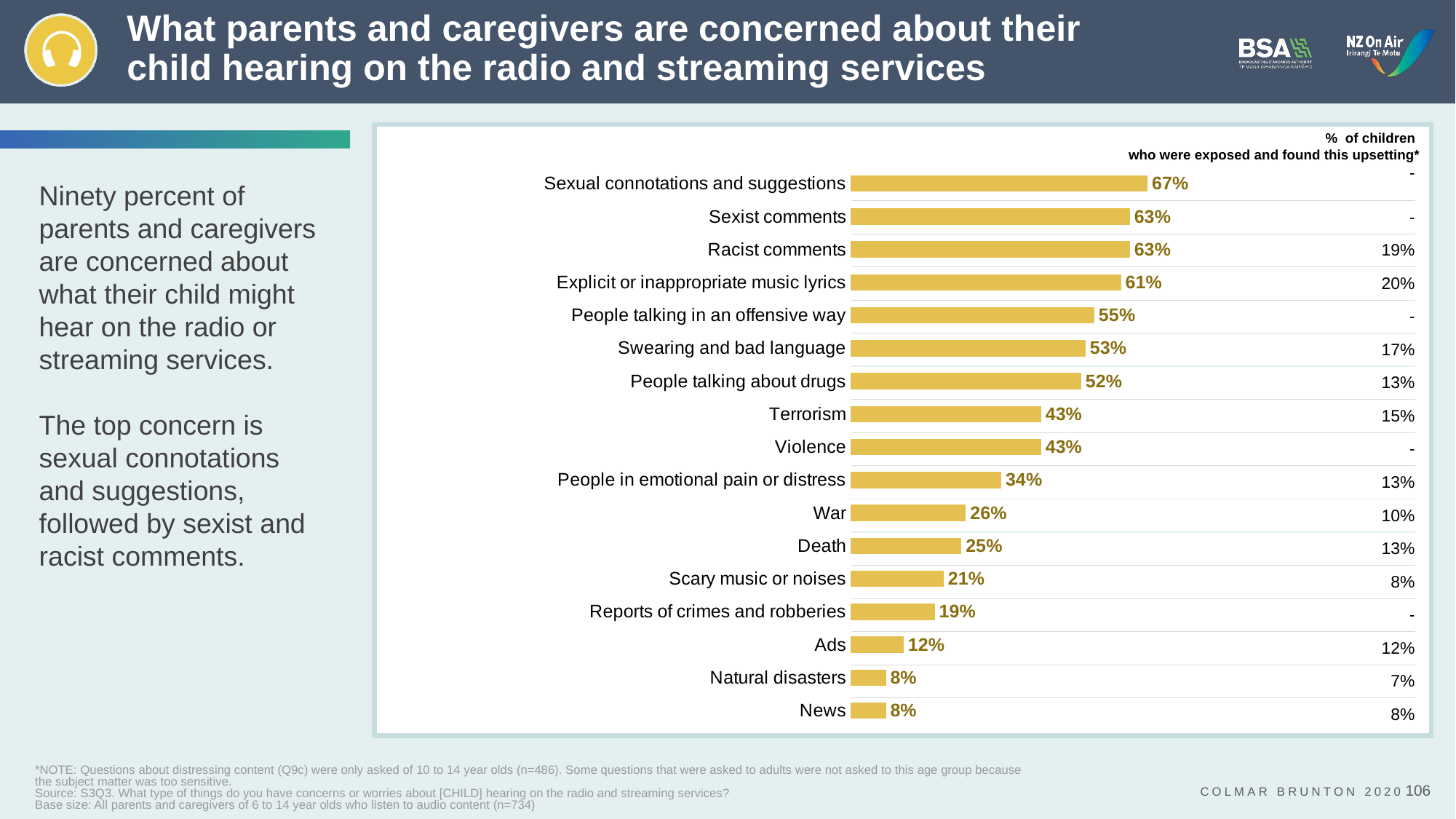
How many concern categories are shown in the chart? 17 Which has a higher value, Scary music or noises or Death? Death What type of chart is used on this slide? Bar chart Which concern has the highest percentage in the chart? Sexual connotations and suggestions What is the difference in percentage points between Sexual connotations and suggestions and Sexist comments? 4 percentage points What is the value shown for Ads? 12% What is the difference in percentage points between Terrorism and War? 17 percentage points What percentage of parents and caregivers are concerned about their child hearing sexual connotations and suggestions? 67% What is the value shown for People in emotional pain or distress? 34% What is the value shown for Swearing and bad language? 53% Which has a higher value, People talking about drugs or Violence? People talking about drugs What colour are the bars in the chart? Yellow/gold